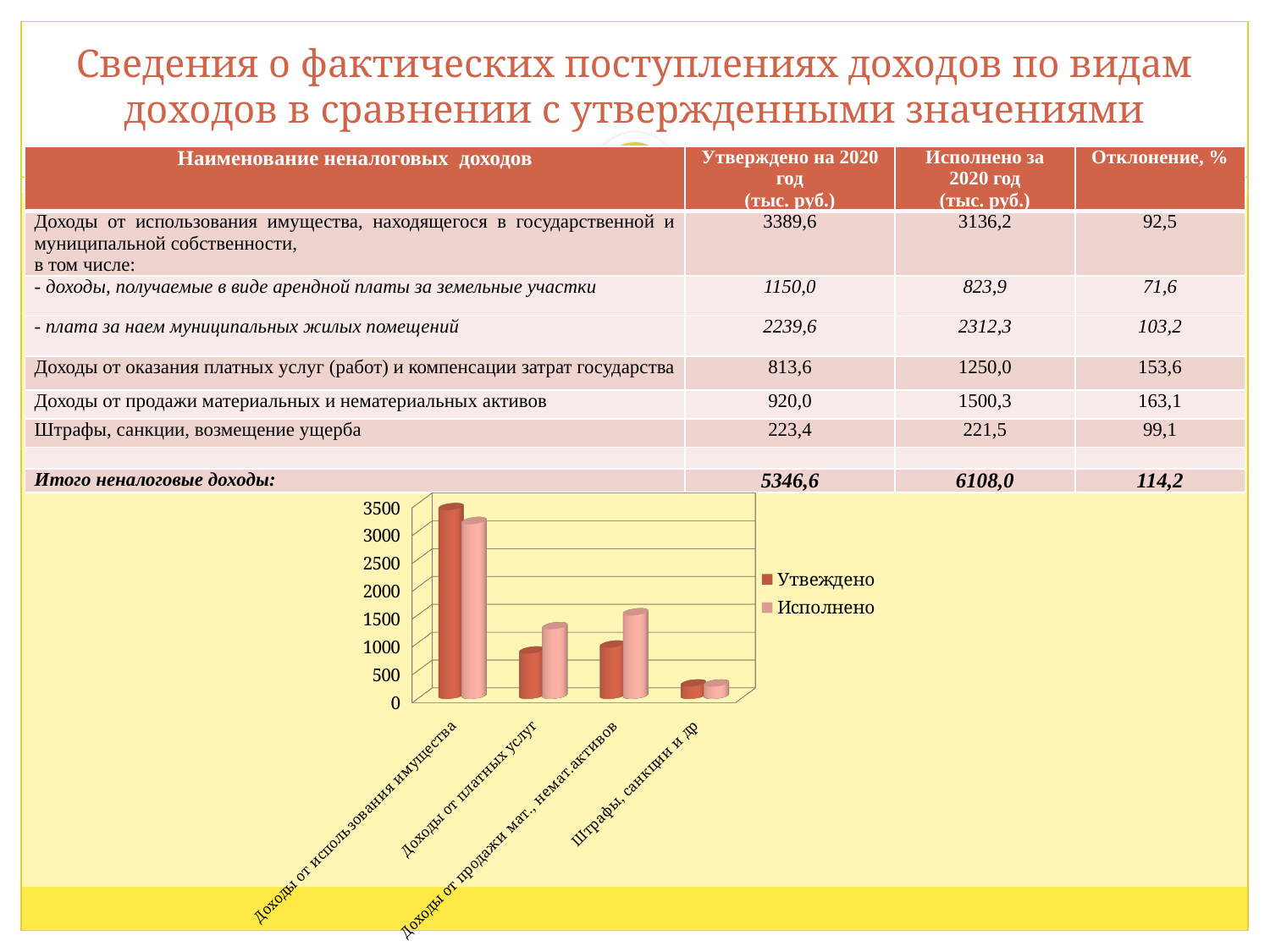
Is the Утвеждено value for Доходы от использования имущества greater or less than 3000? greater Which category has the lowest Исполнено bar in the chart? Штрафы, санкции и др What are the two series named in the chart legend? Утвеждено and Исполнено Is the Утвеждено value for Доходы от платных услуг greater or less than 1000? less For Доходы от использования имущества, which bar is taller: Утвеждено or Исполнено? Утвеждено How many categories are shown on the chart's x axis? 4 Which category has the highest Утвеждено bar in the chart? Доходы от использования имущества For Доходы от продажи мат., немат.активов, which bar is taller: Утвеждено or Исполнено? Исполнено Is the Исполнено value for Штрафы, санкции и др greater or less than 500? less How many series does the chart legend list? 2 What kind of chart is shown on the slide? bar chart